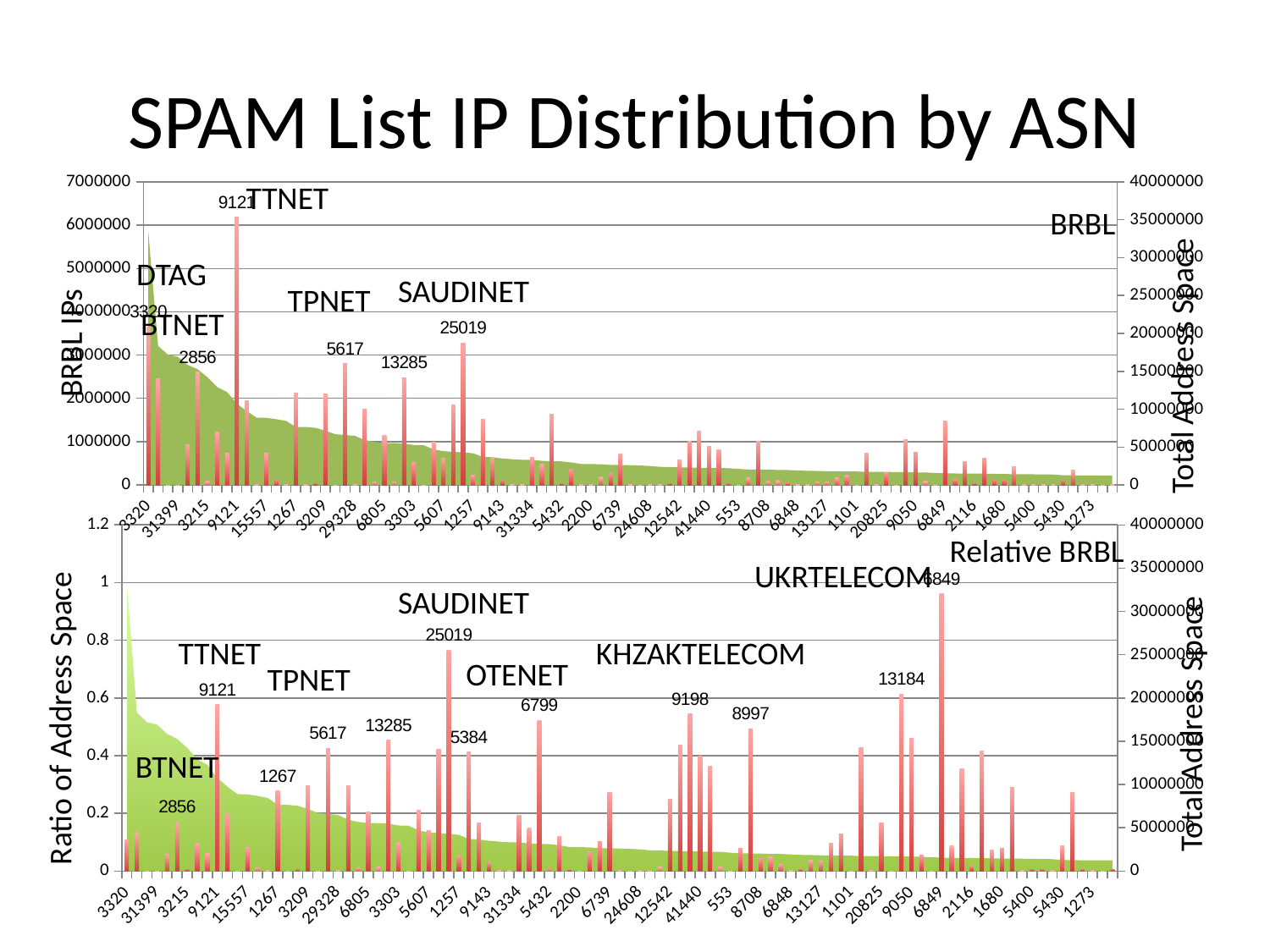
In the bottom chart (Relative BRBL), is the ratio for SAUDINET (25019) greater or less than 0.6? greater What is the label of the left vertical axis of the bottom chart (Relative BRBL)? Ratio of Address Space In the top chart (BRBL), is the BRBL IPs value for TTNET (9121) greater or less than 5000000? greater In the top chart (BRBL), which ASN has the highest BRBL IPs bar? TTNET (9121) In the bottom chart (Relative BRBL), is the ratio for BTNET (2856) greater or less than 0.2? less In the bottom chart (Relative BRBL), which ASN has the highest ratio of address space? UKRTELECOM (6849) In the top chart (BRBL), does the Total Address Space area rise or fall from left to right along the x axis? fall What kind of chart is the top chart (BRBL)? combination area and bar chart In the bottom chart (Relative BRBL), which has the larger ratio, SAUDINET (25019) or TTNET (9121)? SAUDINET (25019) In the top chart (BRBL), which has the larger BRBL IPs value, TTNET (9121) or SAUDINET (25019)? TTNET (9121)